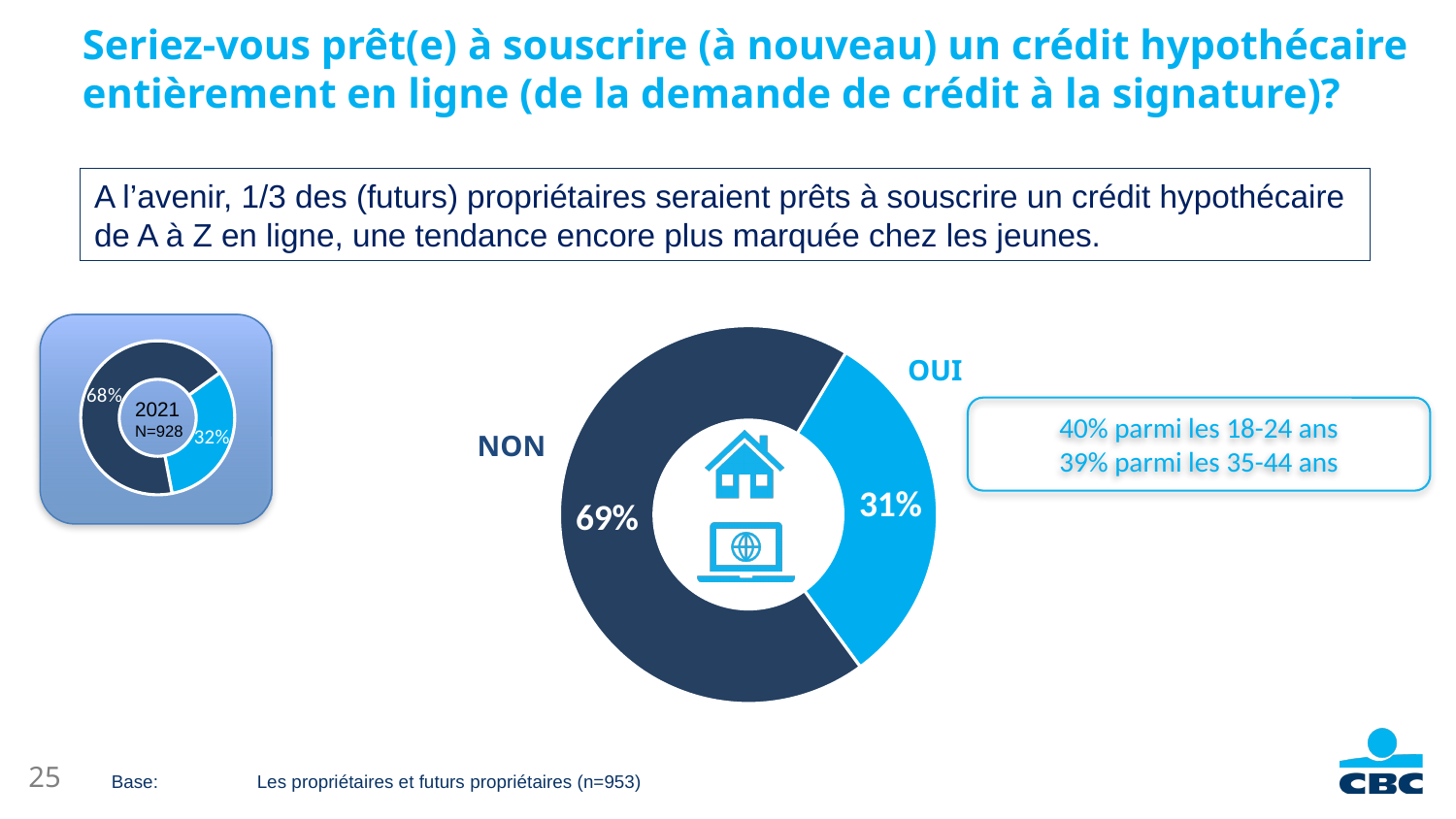
In the small donut chart on the left, what year is shown in the centre? 2021 What kind of chart is the large central chart? Donut (pie) chart In the large central donut chart, what percentage answered OUI? 31% In the large central donut chart, what percentage answered NON? 69% In the small donut chart on the left, what is the difference in percentage points between the two slices? 36 In the large central donut chart, what is the difference in percentage points between NON and OUI? 38 In the large central donut chart, which answer has the larger share, OUI or NON? NON In the small donut chart on the left, what is the larger percentage shown? 68% In the small donut chart on the left, what sample size (N) is shown in the centre? N=928 How many categories does the large central donut chart show? 2 In the small donut chart on the left, what is the smaller percentage shown? 32% In the large central donut chart, is the value for NON greater or less than 50%? greater